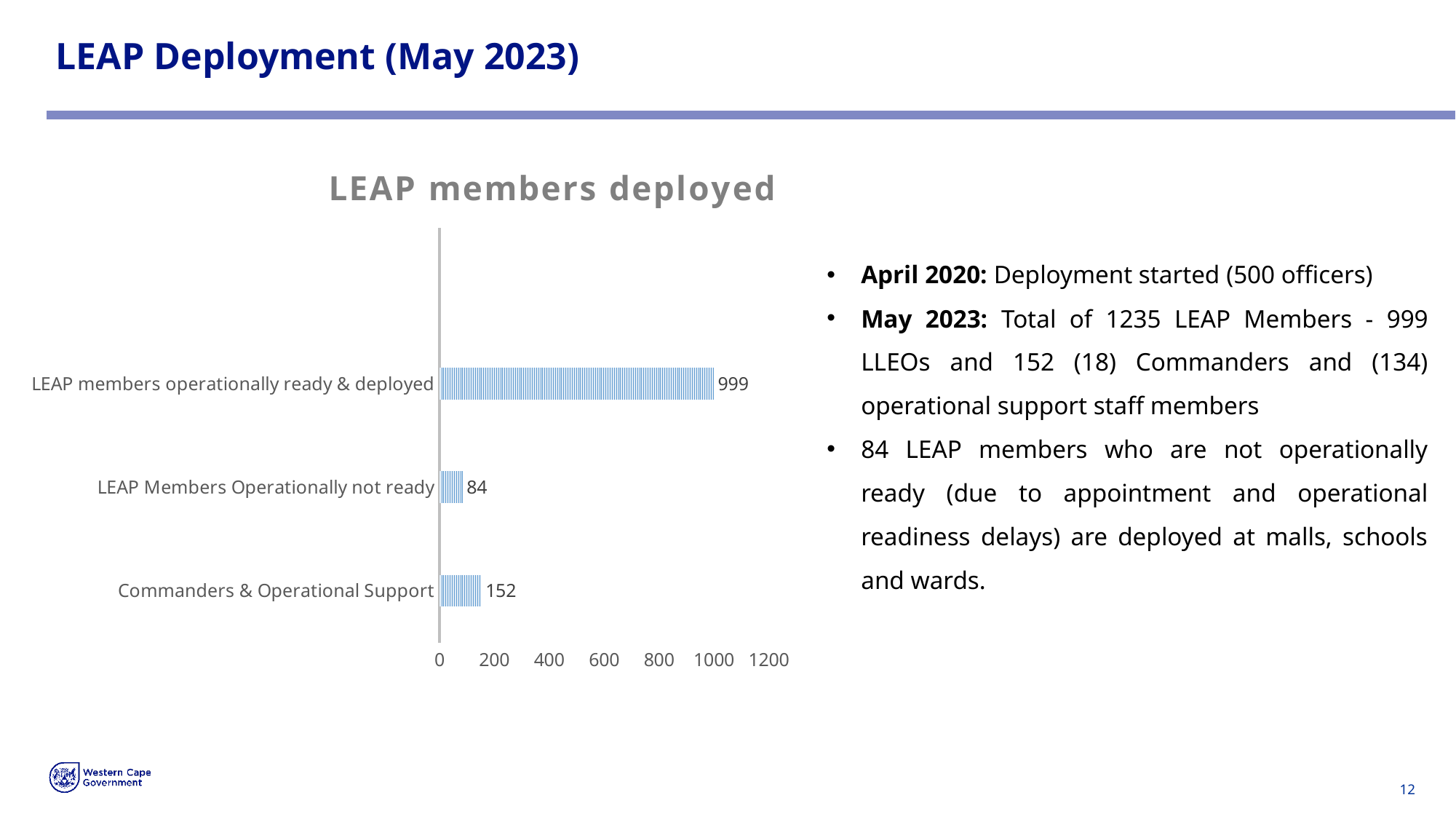
What is the difference between the values for LEAP members operationally ready & deployed and Commanders & Operational Support? 847 How many categories are shown in the chart? 3 Which is larger: Commanders & Operational Support or LEAP Members Operationally not ready? Commanders & Operational Support What is the value for LEAP members operationally ready & deployed? 999 What is the value for Commanders & Operational Support? 152 What is the title of the chart? LEAP members deployed Which category has the highest value? LEAP members operationally ready & deployed Which category has the lowest value? LEAP Members Operationally not ready Is the value for LEAP members operationally ready & deployed greater or less than 800? greater What is the value for LEAP Members Operationally not ready? 84 What is the difference between the values for Commanders & Operational Support and LEAP Members Operationally not ready? 68 What kind of chart is shown on the slide? bar chart